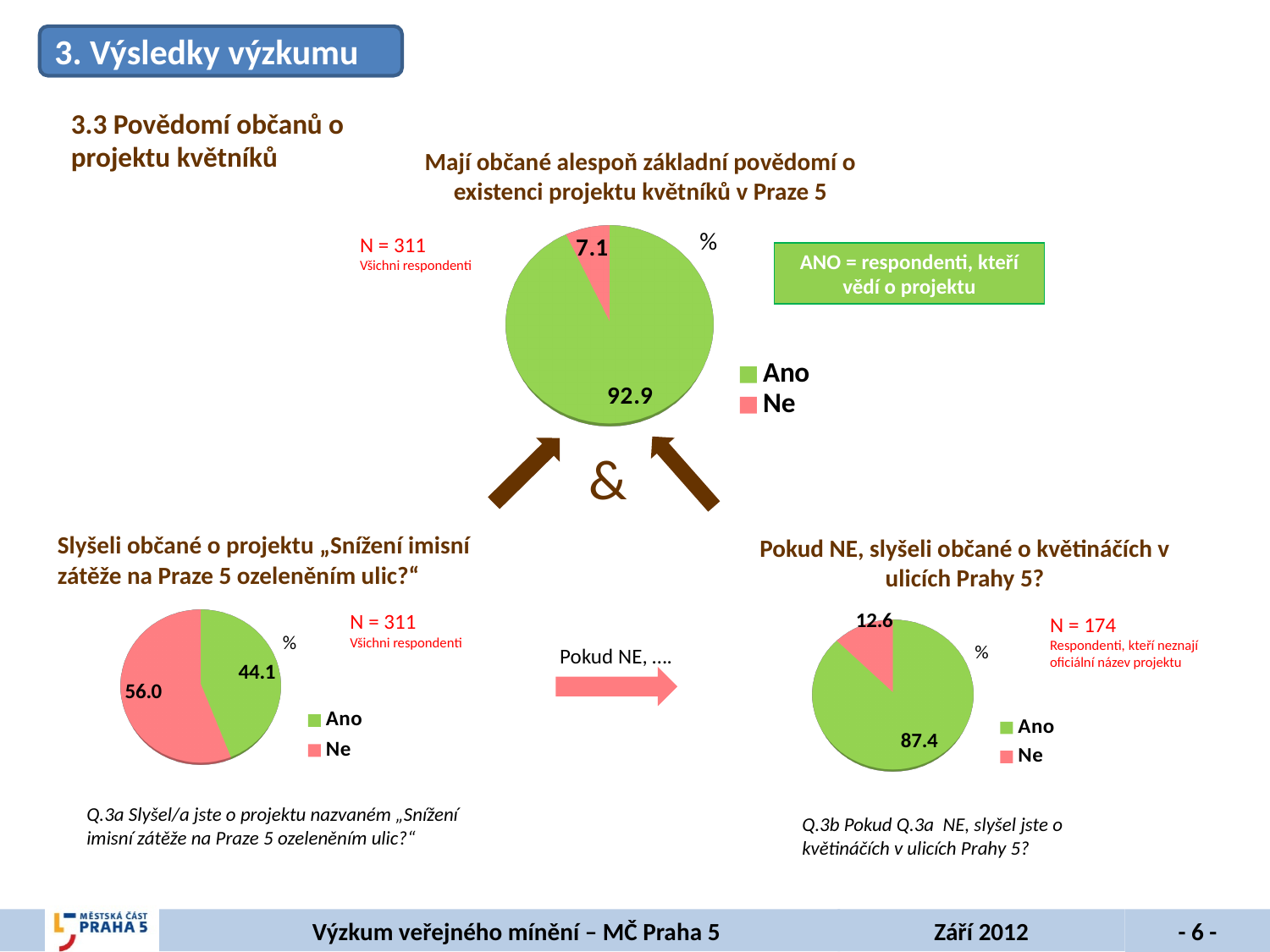
In the bottom-right pie chart (Pokud NE, slyšeli občané o květináčích v ulicích Prahy 5?), what is the value for Ne? 12.6 In the bottom-left pie chart (Slyšeli občané o projektu „Snížení imisní zátěže na Praze 5 ozeleněním ulic?“), what is the value for Ano? 44.1 What type of chart is used for the top chart on the slide? Pie chart In the bottom-left pie chart (Slyšeli občané o projektu „Snížení imisní zátěže na Praze 5 ozeleněním ulic?“), what is the value for Ne? 56.0 In the top pie chart, what is the difference between the Ano and Ne values? 85.8 How many entries does the legend of the bottom-left pie chart list? 2 In the top pie chart, which slice is the largest? Ano In the bottom-right pie chart, which slice is the smallest? Ne In the top pie chart (Mají občané alespoň základní povědomí o existenci projektu květníků v Praze 5), what is the value for Ano? 92.9 In the bottom-right pie chart (Pokud NE, slyšeli občané o květináčích v ulicích Prahy 5?), what is the value for Ano? 87.4 In the top pie chart (Mají občané alespoň základní povědomí o existenci projektu květníků v Praze 5), what is the value for Ne? 7.1 In the bottom-left pie chart, which is larger, Ano or Ne? Ne